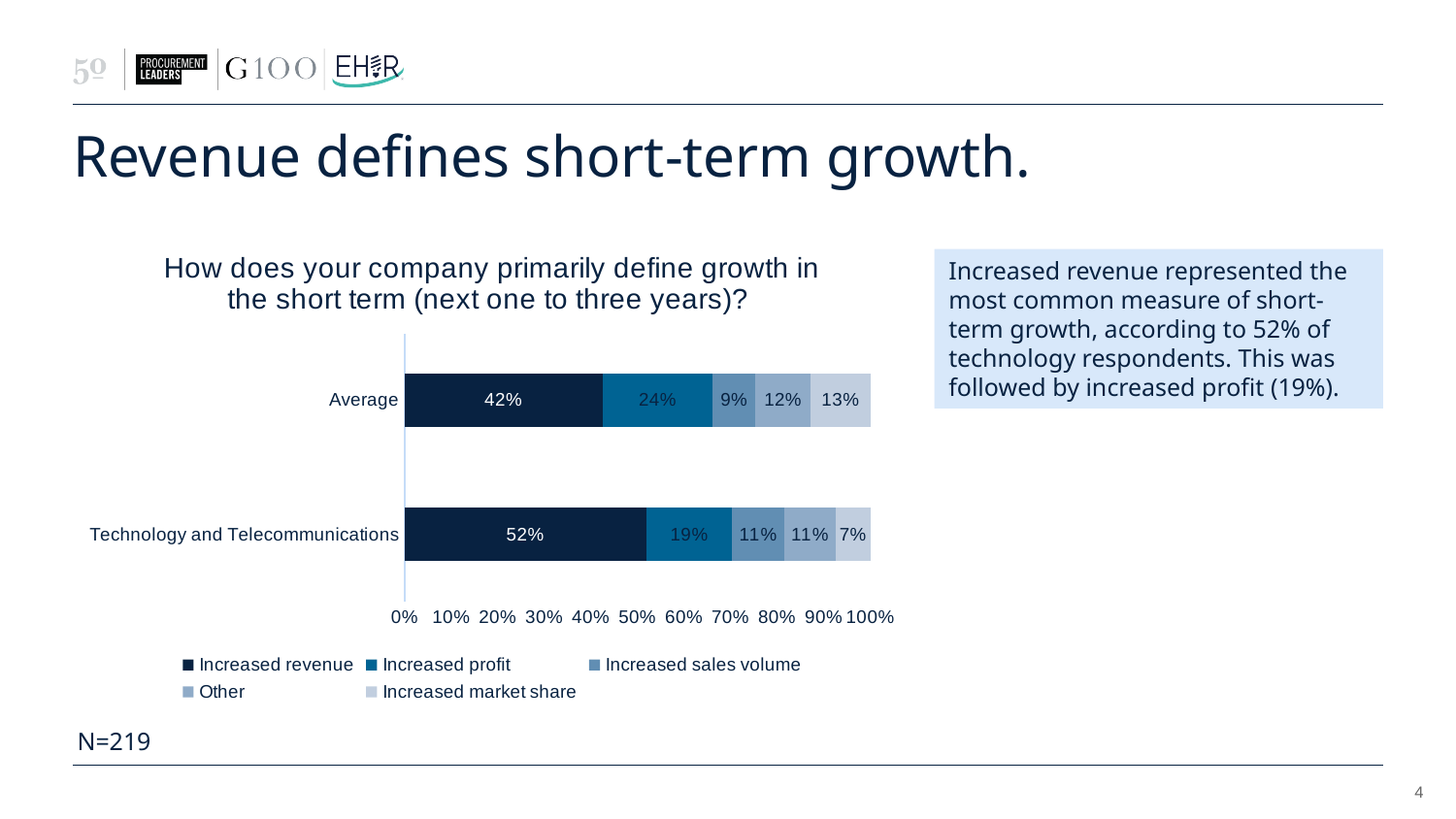
What is the Increased revenue value for Technology and Telecommunications? 52% What is the Increased profit value for Technology and Telecommunications? 19% What is the difference between the Increased revenue values for Technology and Telecommunications and Average? 10% What is the Increased market share value for Average? 13% Which is larger: the Increased profit value for Average or for Technology and Telecommunications? Average What is the sample size (N) shown on the slide? N=219 How many series does the legend list? 5 What is the Increased revenue value for Average? 42% How many categories (bars) are plotted in the chart? 2 Which segment is the largest in the Technology and Telecommunications bar? Increased revenue Which segment is the smallest in the Technology and Telecommunications bar? Increased market share What kind of chart is shown on the slide? Stacked bar chart